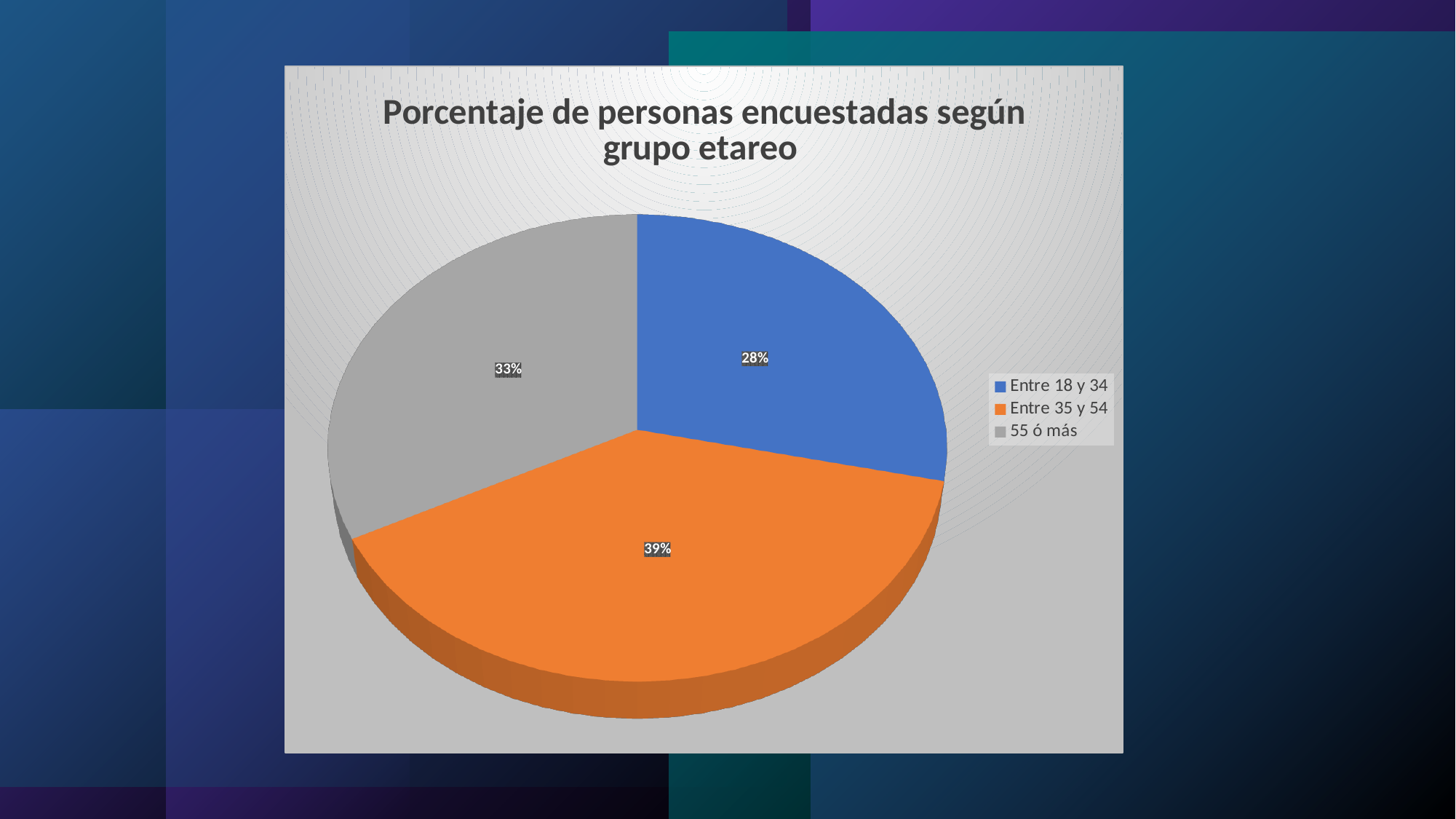
What is the difference in percentage points between the '55 ó más' group and the 'Entre 18 y 34' group? 5 What type of chart is shown on the slide? Pie chart Which age group has the largest share of surveyed people? Entre 35 y 54 What colour represents the 'Entre 35 y 54' group? Orange What percentage of surveyed people are in the '55 ó más' group? 33% What percentage of surveyed people are in the 'Entre 18 y 34' group? 28% What percentage of surveyed people are in the 'Entre 35 y 54' group? 39% Which group has a larger share: '55 ó más' or 'Entre 18 y 34'? 55 ó más What is the title of the chart? Porcentaje de personas encuestadas según grupo etareo What is the difference in percentage points between the 'Entre 35 y 54' group and the 'Entre 18 y 34' group? 11 Which age group has the smallest share of surveyed people? Entre 18 y 34 How many age groups are shown in the pie chart? 3